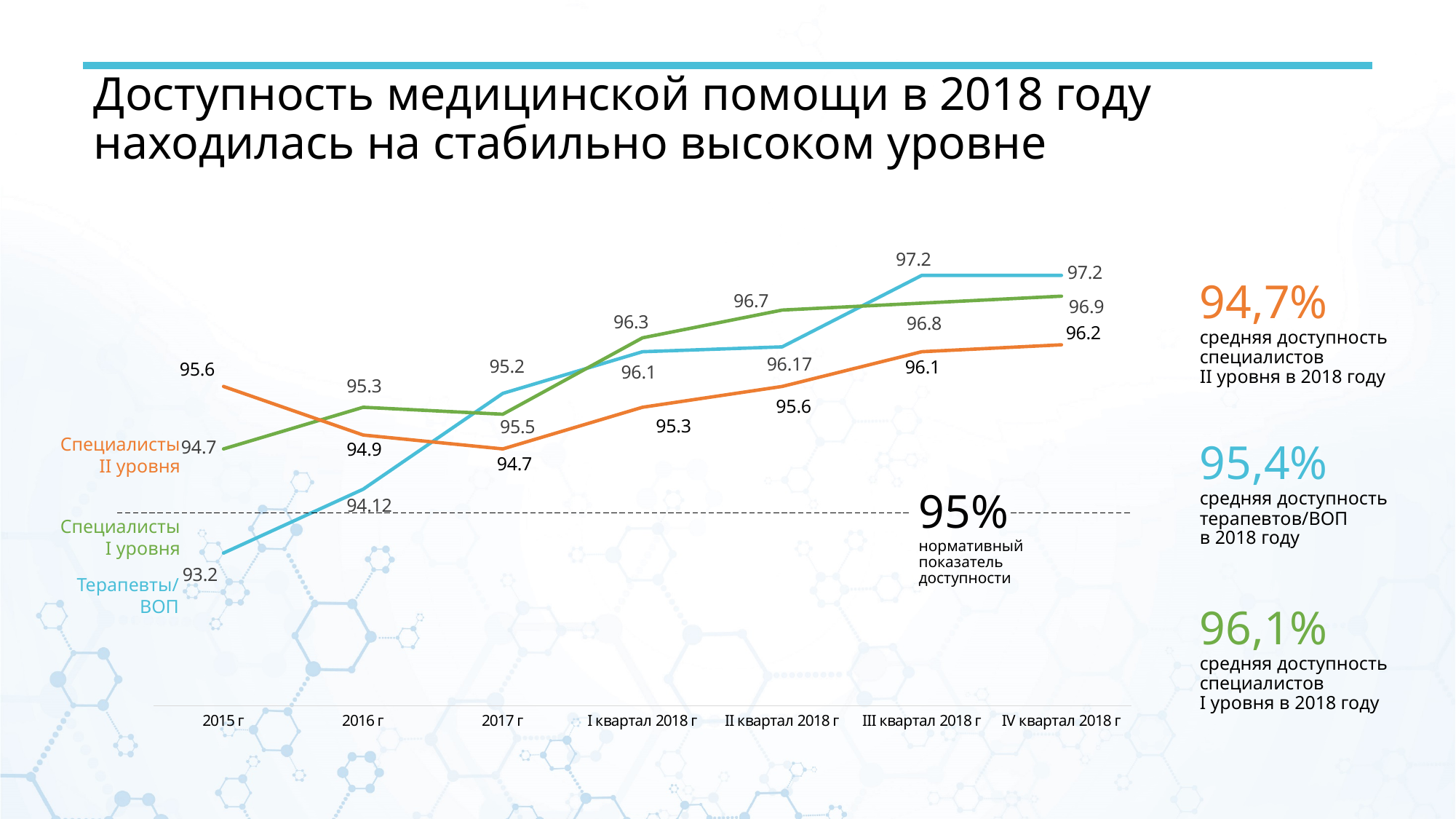
What is the lowest value plotted for Терапевты/ВОП, and in which period? 93.2, 2015 г What type of chart is shown on the slide? line chart Is the value for Терапевты/ВОП in 2015 г greater or less than 95? less What is the value for Специалисты II уровня in 2017 г? 94.7 How many series (lines) are plotted on the chart? 3 How many points are shown along the x axis of the chart? 7 What is the highest value reached by the Терапевты/ВОП line? 97.2 What is the value for Специалисты I уровня in IV квартал 2018 г? 96.9 In IV квартал 2018 г, which is higher: Терапевты/ВОП or Специалисты II уровня? Терапевты/ВОП What is the difference between the Специалисты I уровня and Специалисты II уровня values in IV квартал 2018 г? 0.7 What is the value for Терапевты/ВОП in 2015 г? 93.2 What is the normative availability indicator marked by the dashed line on the chart? 95%